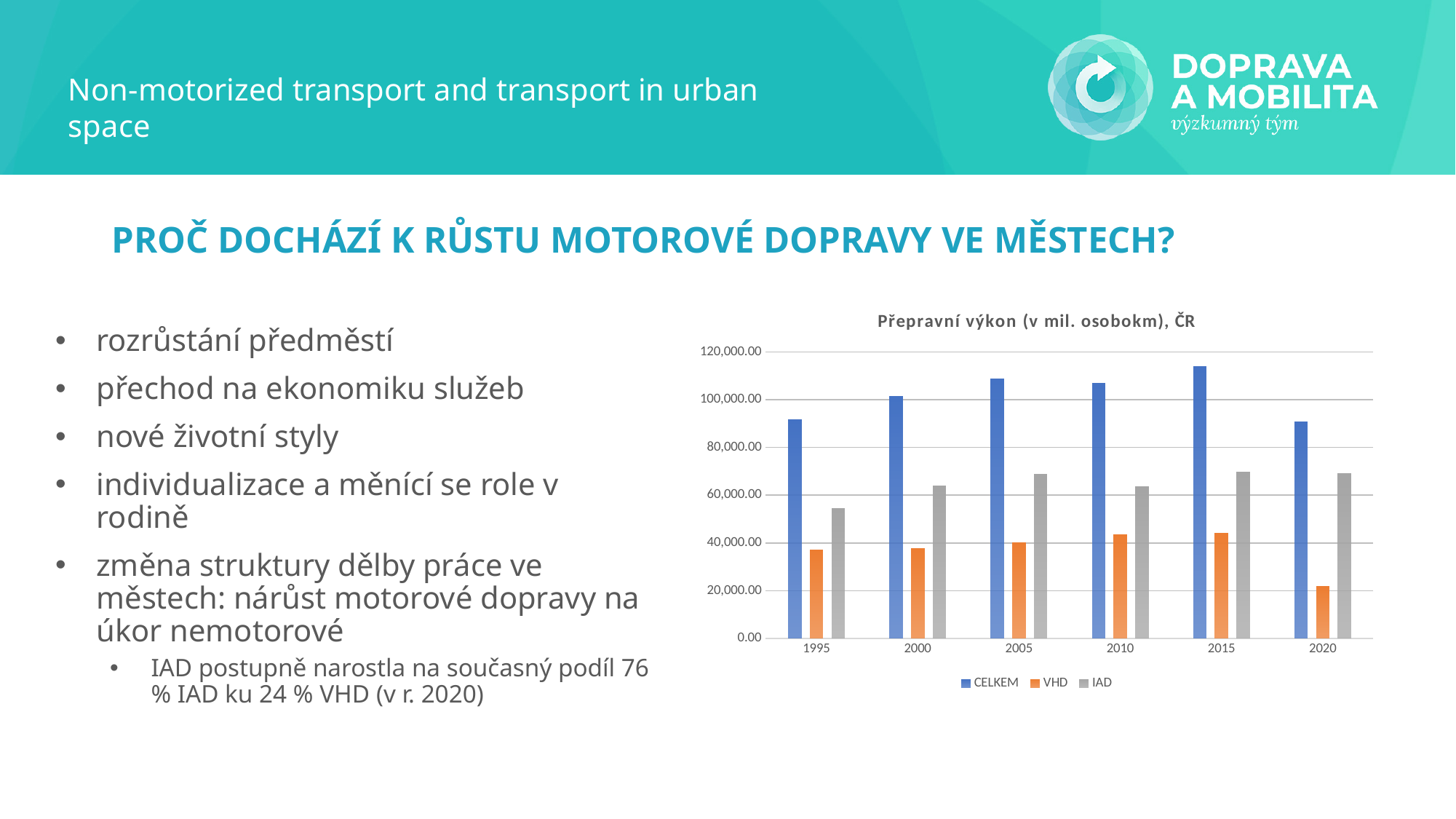
What kind of chart is shown on the slide? bar chart In which year is the VHD value lowest? 2020 Is the IAD value for 2005 greater or less than 60,000.00? greater Is the VHD value for 2020 greater or less than 40,000.00? less In which year is the CELKEM value highest? 2015 What is the title of the chart? Přepravní výkon (v mil. osobokm), ČR Which is larger in 2010, the VHD value or the IAD value? IAD How many series does the chart legend list? 3 Which series is shown in orange in the chart? VHD In which year is the IAD value lowest? 1995 Is the CELKEM value for 2000 greater or less than 100,000.00? greater How many years are shown on the x axis of the chart? 6